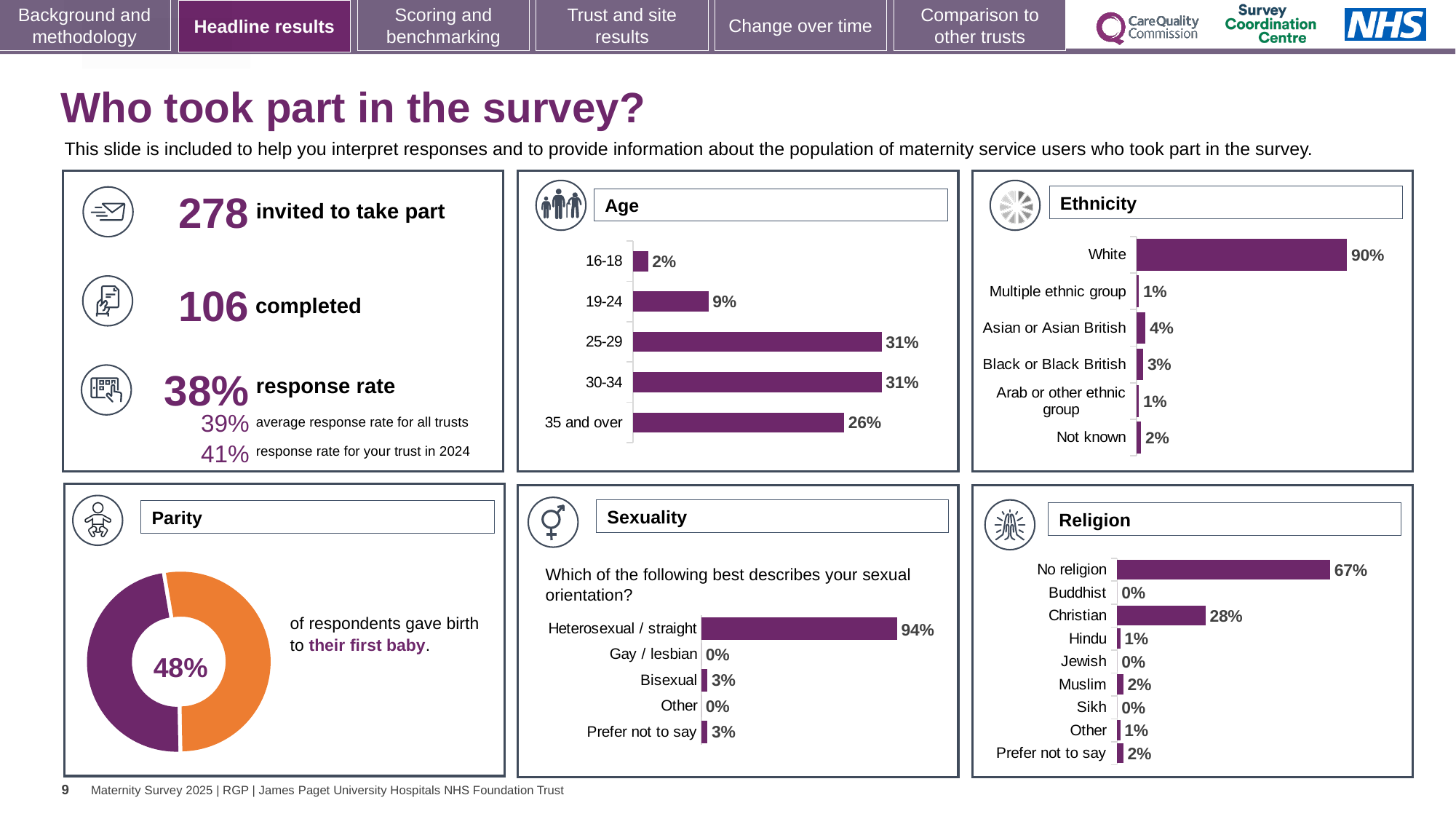
In the Sexuality chart, what percentage of respondents answered Heterosexual / straight? 94% What kind of chart is the Parity chart? Doughnut chart In the Ethnicity chart, which is larger: Asian or Asian British, or Black or Black British? Asian or Asian British In the Ethnicity chart, what percentage of respondents were White? 90% In the Age chart, what percentage of respondents were aged 25-29? 31% How many categories are shown in the Ethnicity chart? 6 In the Ethnicity chart, which category has the highest percentage? White In the Age chart, what is the difference between the 35 and over group and the 19-24 group? 17% How many categories are shown in the Religion chart? 9 In the Religion chart, what percentage of respondents answered Christian? 28% In the Parity chart, what percentage of respondents gave birth to their first baby? 48% In the Age chart, which age group has the lowest percentage? 16-18